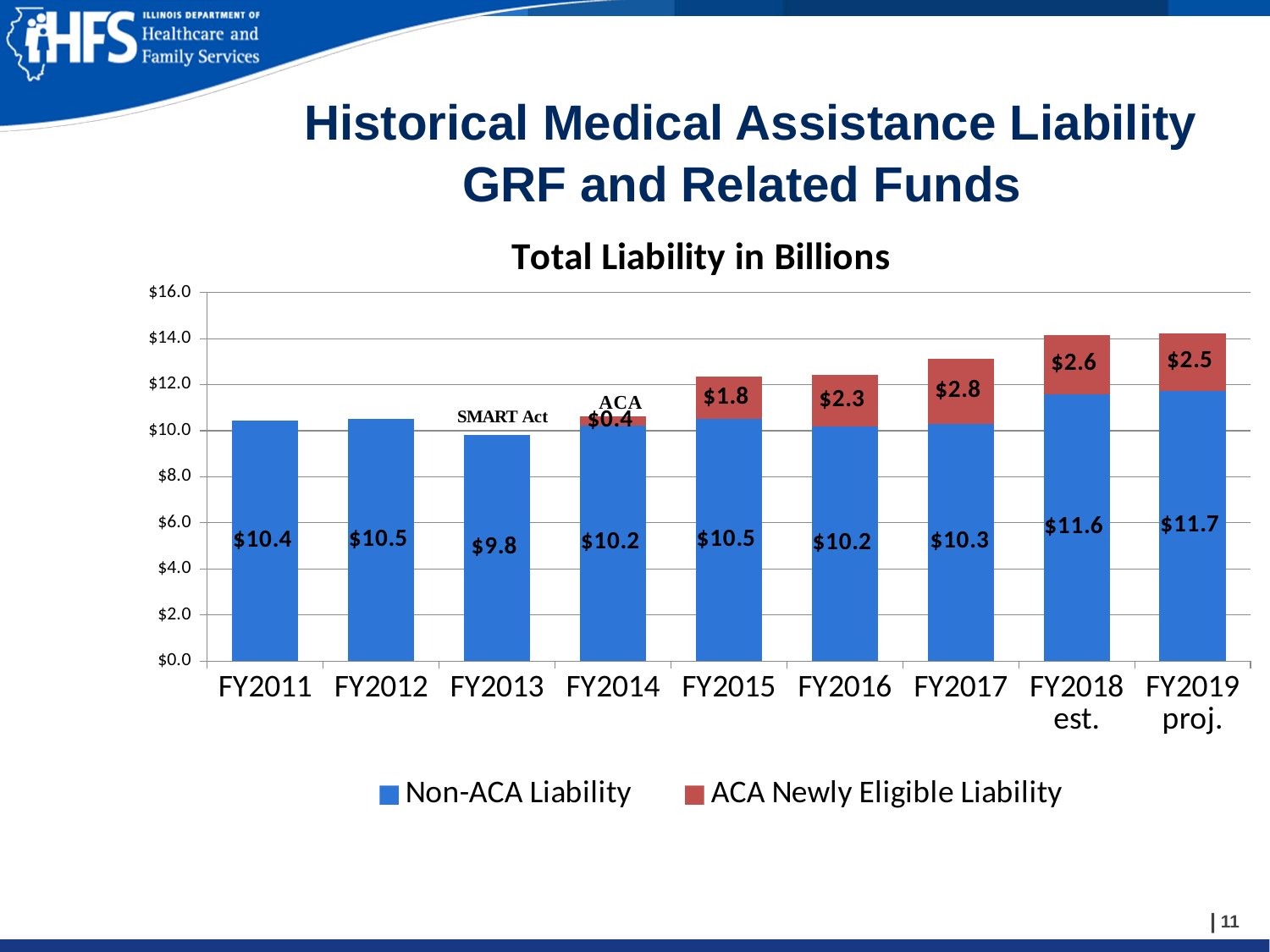
How many fiscal years are shown on the x axis? 9 What is the difference between the Non-ACA Liability for FY2018 est. and FY2017? $1.3 Which is larger, the ACA Newly Eligible Liability for FY2016 or for FY2015? FY2016 What is the ACA Newly Eligible Liability value for FY2017? $2.8 What is the Non-ACA Liability value for FY2019 proj.? $11.7 Which fiscal year has the highest ACA Newly Eligible Liability? FY2017 What is the total liability for FY2017 (Non-ACA plus ACA Newly Eligible)? $13.1 What kind of chart is shown on the slide? Stacked bar chart What is the title of the chart? Total Liability in Billions How many series does the legend list? 2 Which fiscal year has the lowest Non-ACA Liability? FY2013 What is the Non-ACA Liability value for FY2013? $9.8